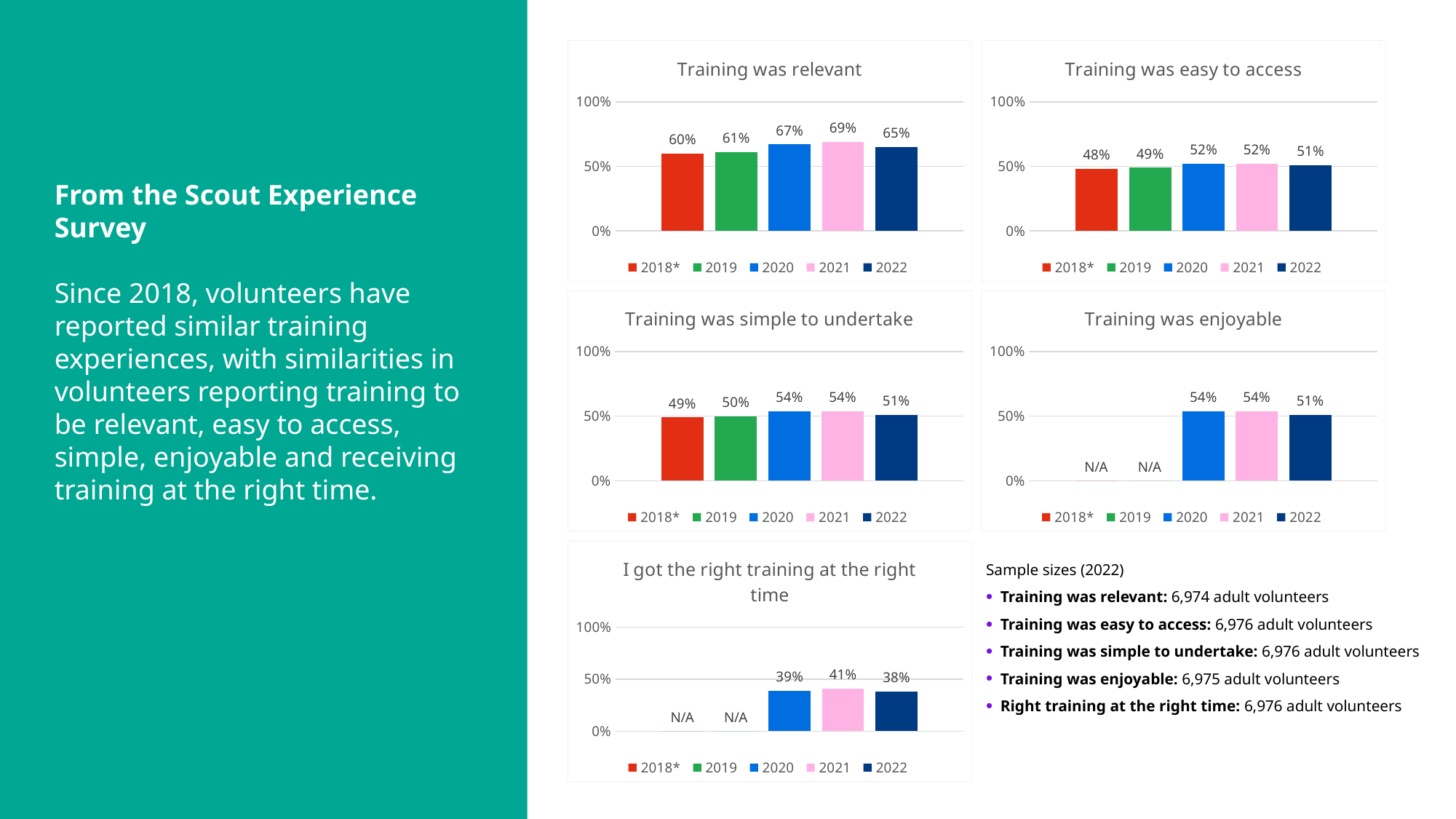
In the 'I got the right training at the right time' chart, is the value for 2022 greater or less than 50%? less In the 'Training was enjoyable' chart, which years are shown as N/A? 2018* and 2019 In the 'Training was enjoyable' chart, what is the value for 2022? 51% In the 'Training was relevant' chart, which is larger, the value for 2020 or the value for 2022? 2020 In the 'Training was relevant' chart, which year has the highest value? 2021 In the 'I got the right training at the right time' chart, what is the value for 2021? 41% How many series does the legend list in the 'Training was simple to undertake' chart? 5 In the 'Training was relevant' chart, what is the value for 2021? 69% In the 'Training was simple to undertake' chart, what is the difference between the 2020 value and the 2018* value? 5% What kind of chart is 'Training was easy to access'? Bar chart In the 'Training was easy to access' chart, which year has the lowest value? 2018* In the 'Training was easy to access' chart, what is the value for 2018*? 48%